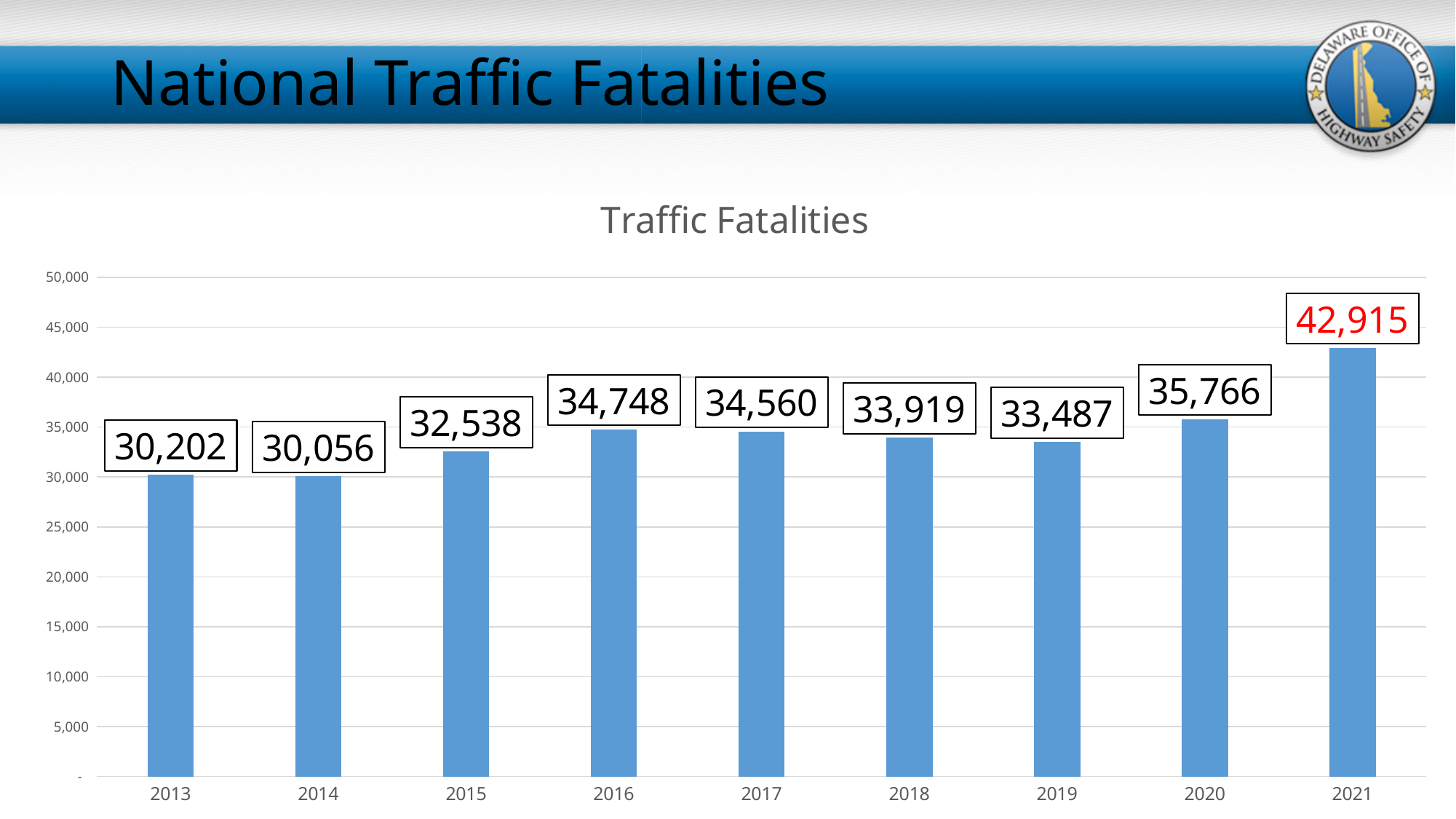
What is the value for 2013? 30,202 What is the title of the chart? Traffic Fatalities What is the difference between the values for 2021 and 2020? 7,149 What kind of chart is shown on the slide? Bar chart Which is larger, the value for 2016 or the value for 2019? 2016 How many years are shown on the x axis? 9 What is the value for 2018? 33,919 What is the value for 2021? 42,915 What is the difference between the values for 2016 and 2015? 2,210 Which year has the lowest number of traffic fatalities? 2014 Is the value for 2020 greater or less than 35,000? greater Which year has the highest number of traffic fatalities? 2021